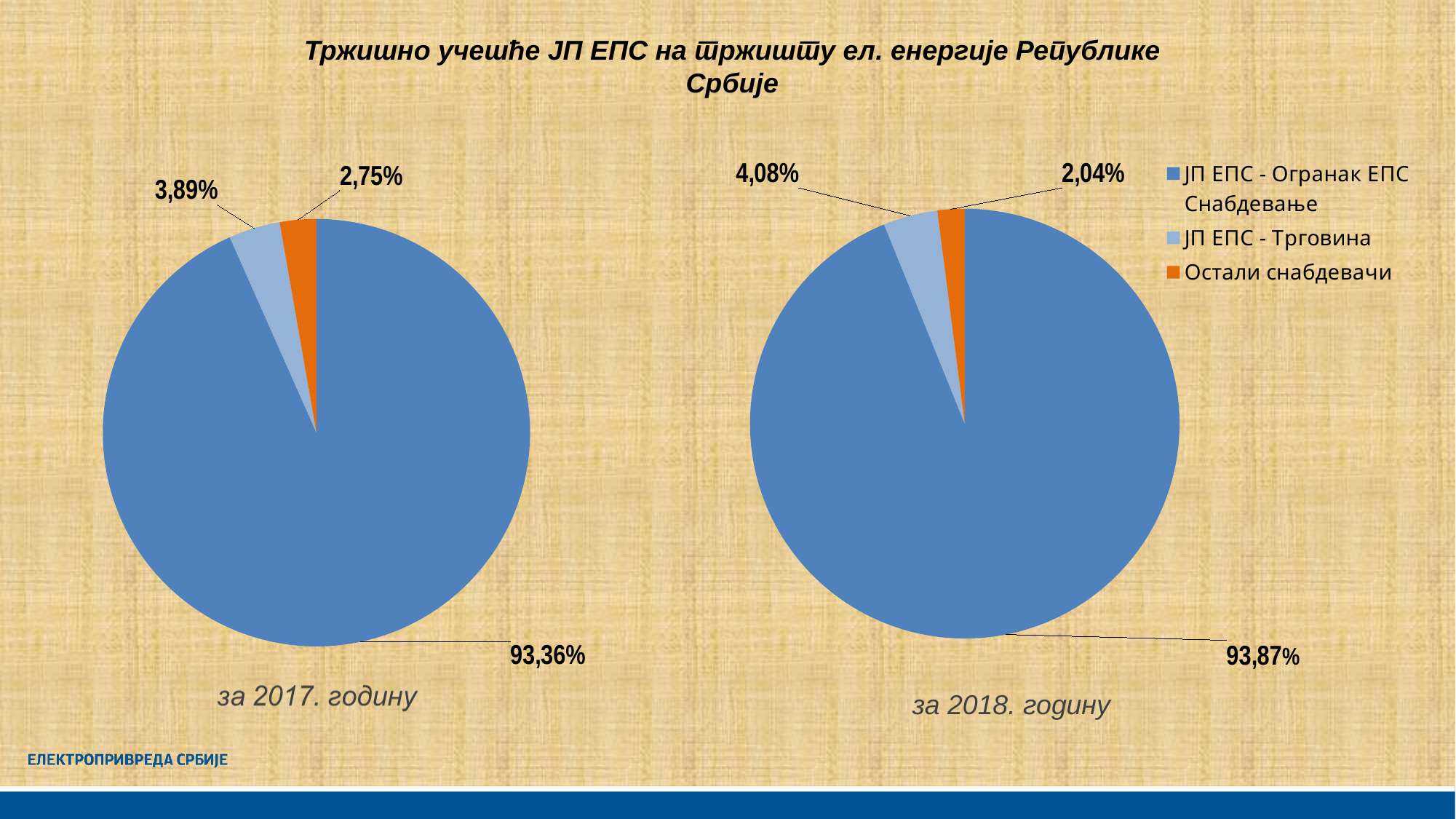
In the pie chart for 2018 (за 2018. годину), what share does ЈП ЕПС - Трговина hold? 4,08% In the pie chart for 2017 (за 2017. годину), which is larger: the slice for ЈП ЕПС - Трговина or the slice for Остали снабдевачи? ЈП ЕПС - Трговина What type of chart is used on this slide? Pie chart What is the difference between the share of Остали снабдевачи in the 2017 pie chart and in the 2018 pie chart? 0,71% In the pie chart for 2017 (за 2017. годину), what is the share of Остали снабдевачи? 2,75% In the pie chart for 2017 (за 2017. годину), what share does ЈП ЕПС - Огранак ЕПС Снабдевање hold? 93,36% In the pie chart for 2018 (за 2018. годину), which category has the smallest slice? Остали снабдевачи In the pie chart for 2017 (за 2017. годину), which category has the largest slice? ЈП ЕПС - Огранак ЕПС Снабдевање What is the difference between the share of ЈП ЕПС - Огранак ЕПС Снабдевање in the 2018 pie chart and in the 2017 pie chart? 0,51% Which colour represents Остали снабдевачи in the legend? Orange In the pie chart for 2018 (за 2018. годину), what is the share of Остали снабдевачи? 2,04% How many slices does the pie chart for 2017 (за 2017. годину) have? 3